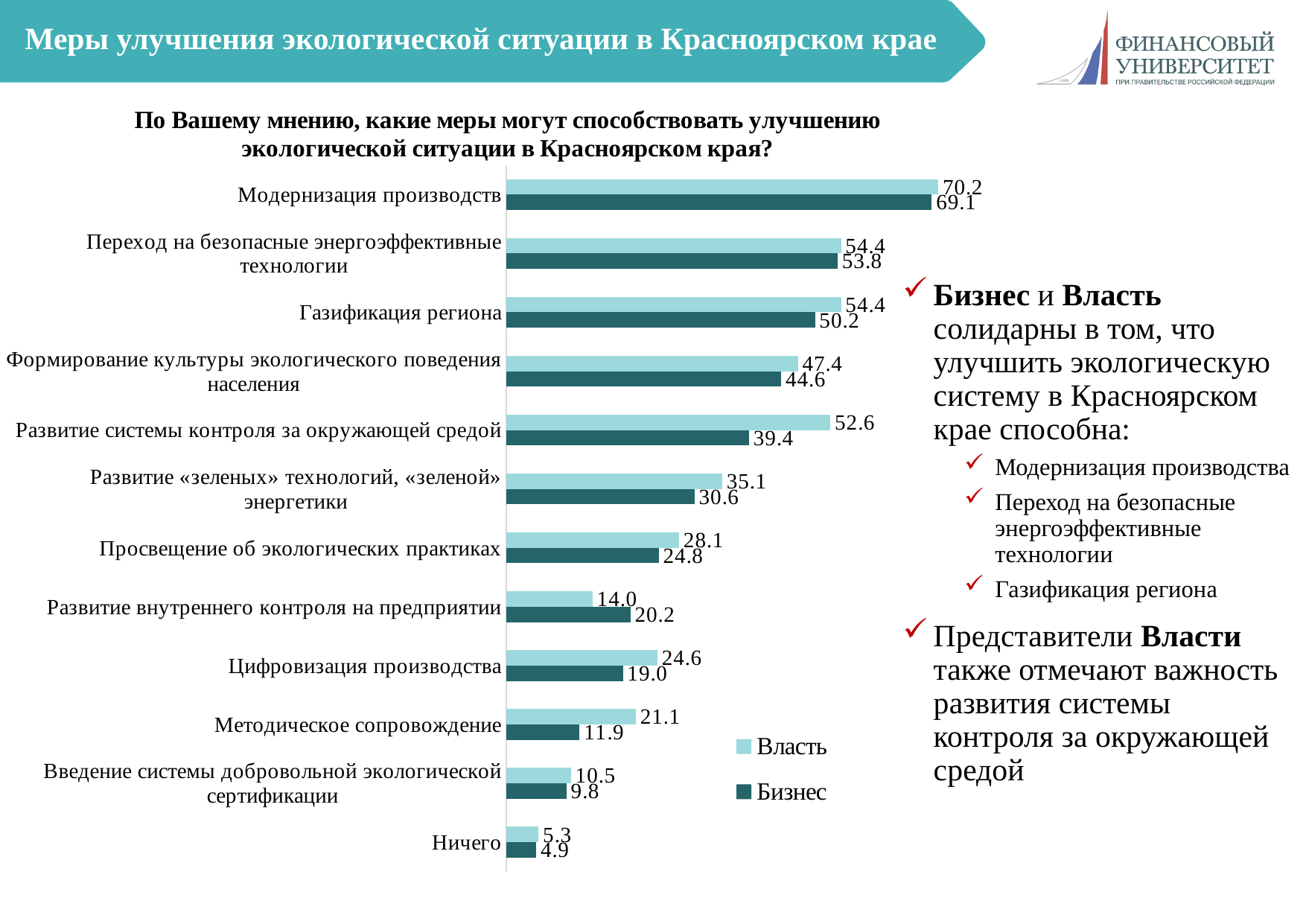
What kind of chart is shown on the slide? Bar chart What value does the chart show for Власть on Модернизация производств? 70.2 For Развитие внутреннего контроля на предприятии, which series has the larger value, Власть or Бизнес? Бизнес How many categories are shown on the chart? 12 What value does the chart show for Бизнес on Газификация региона? 50.2 What value does the chart show for Бизнес on Развитие внутреннего контроля на предприятии? 20.2 For Методическое сопровождение, which series has the larger value, Власть or Бизнес? Власть Which series is shown in the darker colour in the legend? Бизнес Which category has the highest value for Бизнес? Модернизация производств Which category has the lowest value for Власть? Ничего How many series does the legend list? 2 What is the difference between the Власть and Бизнес values for Развитие системы контроля за окружающей средой? 13.2